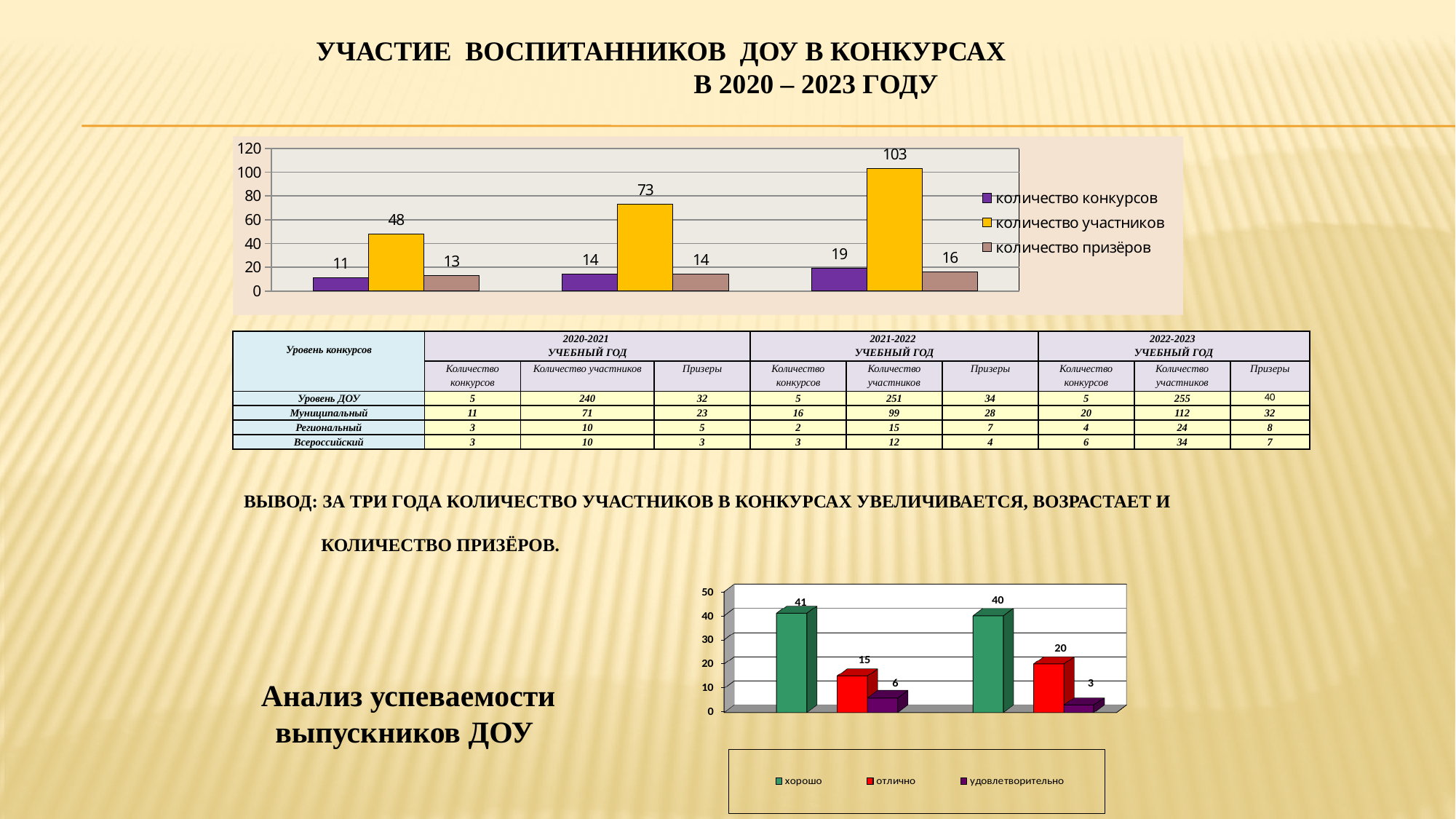
In the bottom chart, what is the difference between the 'хорошо' values in the first and second groups of bars? 1 In the top chart, how many series does the legend list? 3 In the top chart, what is the value of the 'количество участников' bar in the third group of bars? 103 In the top chart, which series has the tallest bar in every group? количество участников What kind of chart is the top chart? bar chart In the bottom chart, what is the value of the 'отлично' bar in the second group of bars? 20 In the top chart, do the 'количество участников' values rise or fall from the first group to the third group? rise In the bottom chart, which series has the lowest value in the second group of bars? удовлетворительно In the bottom chart, what is the value of the 'удовлетворительно' bar in the first group of bars? 6 In the top chart, what is the difference between the 'количество участников' values in the third and first groups of bars? 55 In the top chart, what is the value of the 'количество конкурсов' bar in the first group of bars? 11 In the top chart, what is the value of the 'количество призёров' bar in the second group of bars? 14